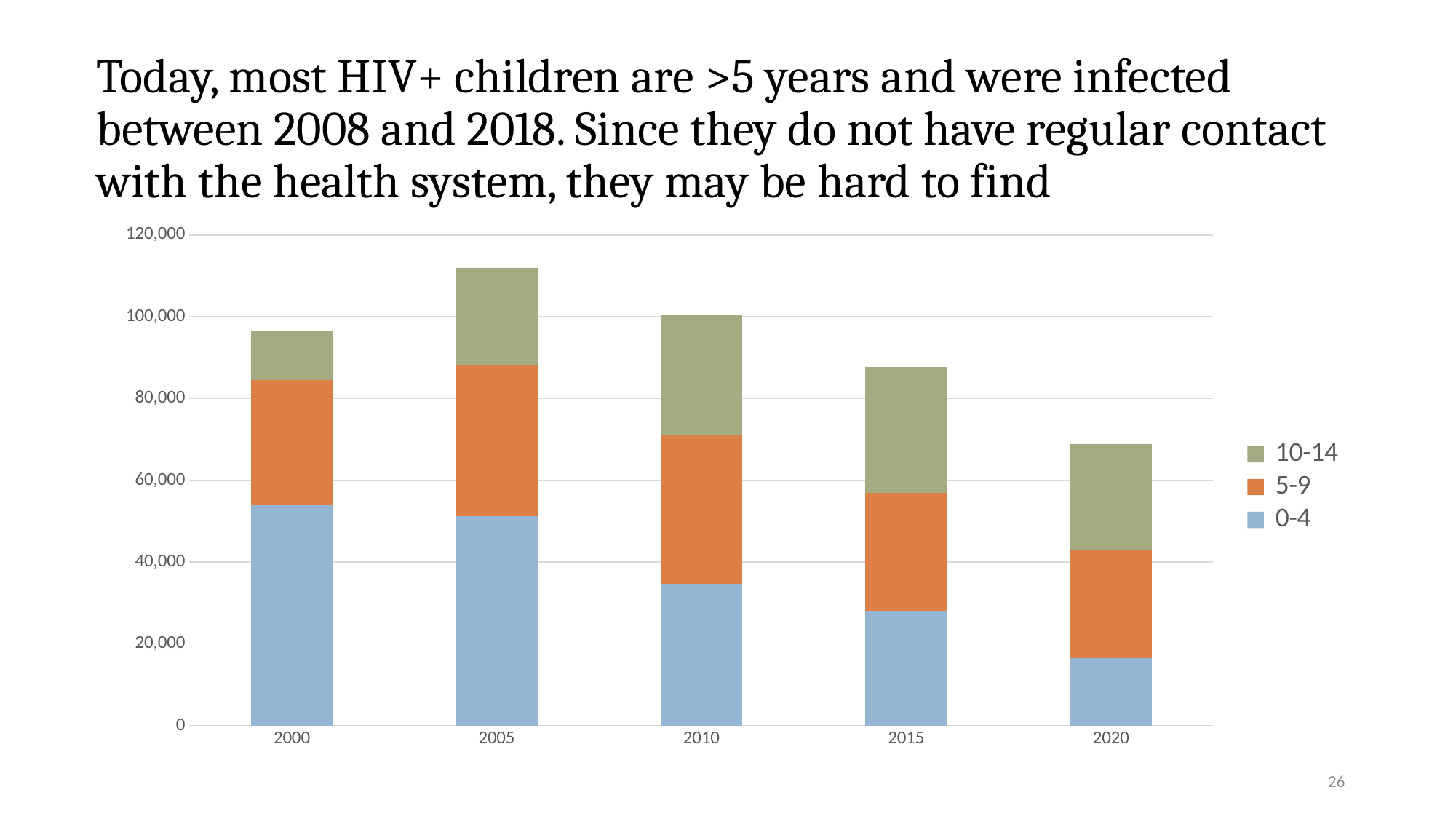
Which year has the larger 0-4 segment, 2000 or 2020? 2000 Is the total stacked value for 2020 greater or less than 80,000? less Is the total stacked value for 2005 greater or less than 100,000? greater How many series does the chart's legend list? 3 Does the 0-4 segment rise or fall from 2000 to 2020? Fall Which year has the shortest stacked bar in the chart? 2020 What kind of chart is shown on the slide? Stacked bar chart Which year has the tallest stacked bar in the chart? 2005 Is the value of the 0-4 segment for 2020 greater or less than 20,000? less How many years (categories) are shown on the x axis of the chart? 5 Which age group is shown in blue in the chart's legend? 0-4